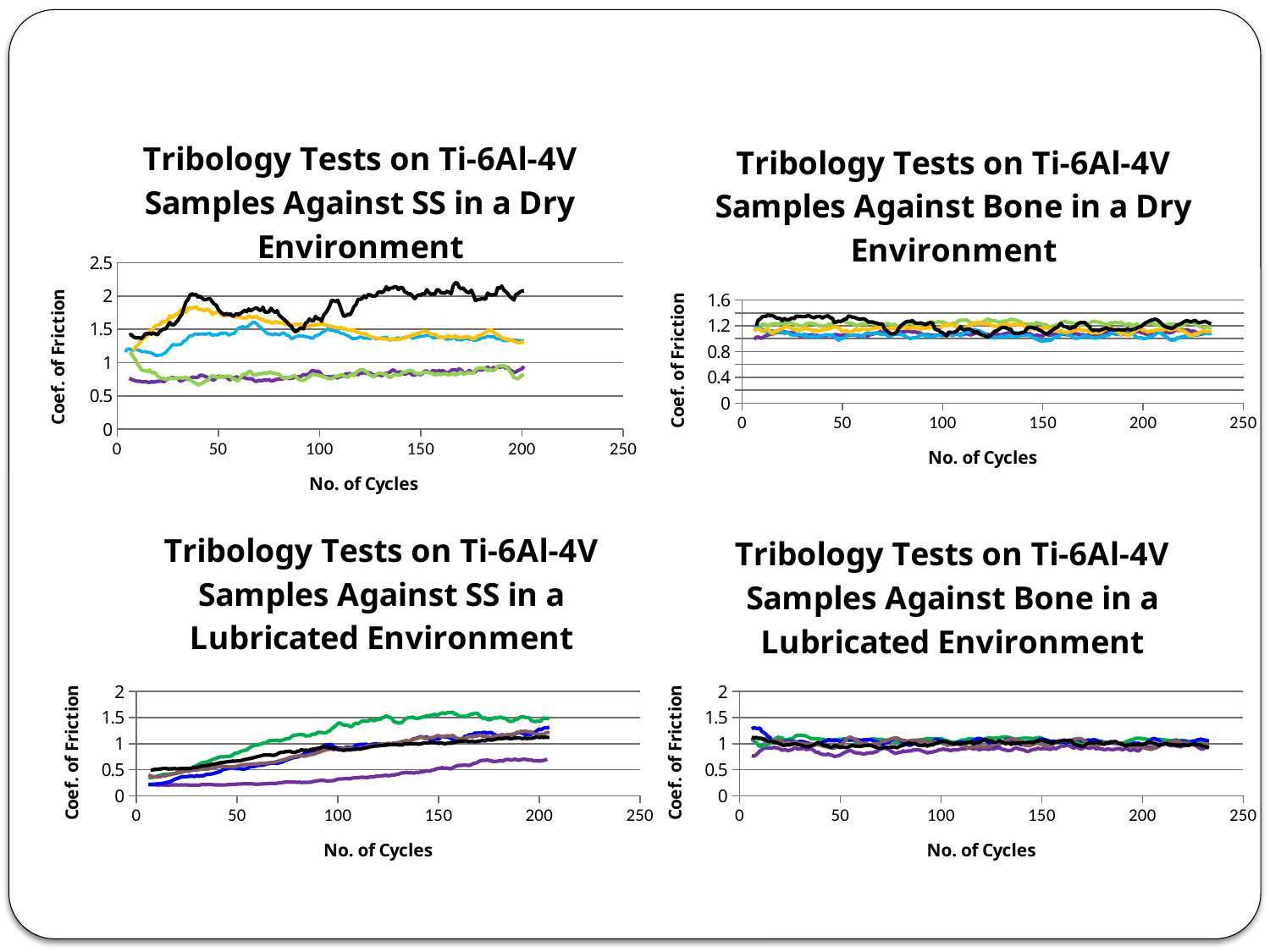
In the top-left chart (SS in a Dry Environment), is the value of the black line at 150 cycles greater or less than 1.5? greater In the bottom-left chart (SS in a Lubricated Environment), does the green line generally rise or fall as the number of cycles increases? Rise In the top-left chart (SS in a Dry Environment), is the value of the purple line at 100 cycles greater or less than 1? less In the bottom-left chart (SS in a Lubricated Environment), which colour line is lowest at 150 cycles? Purple In the bottom-left chart (SS in a Lubricated Environment), is the value of the purple line at 50 cycles greater or less than 0.5? less What is the label on the y axis of the top-right chart (Bone in a Dry Environment)? Coef. of Friction In the top-left chart (SS in a Dry Environment), which colour line is highest at 150 cycles? Black How many charts are shown on the slide? 4 What kind of chart is the top-left chart, 'Tribology Tests on Ti-6Al-4V Samples Against SS in a Dry Environment'? Line chart What is the label on the x axis of the bottom-right chart (Bone in a Lubricated Environment)? No. of Cycles In the bottom-left chart (SS in a Lubricated Environment), which colour line is highest at 150 cycles? Green